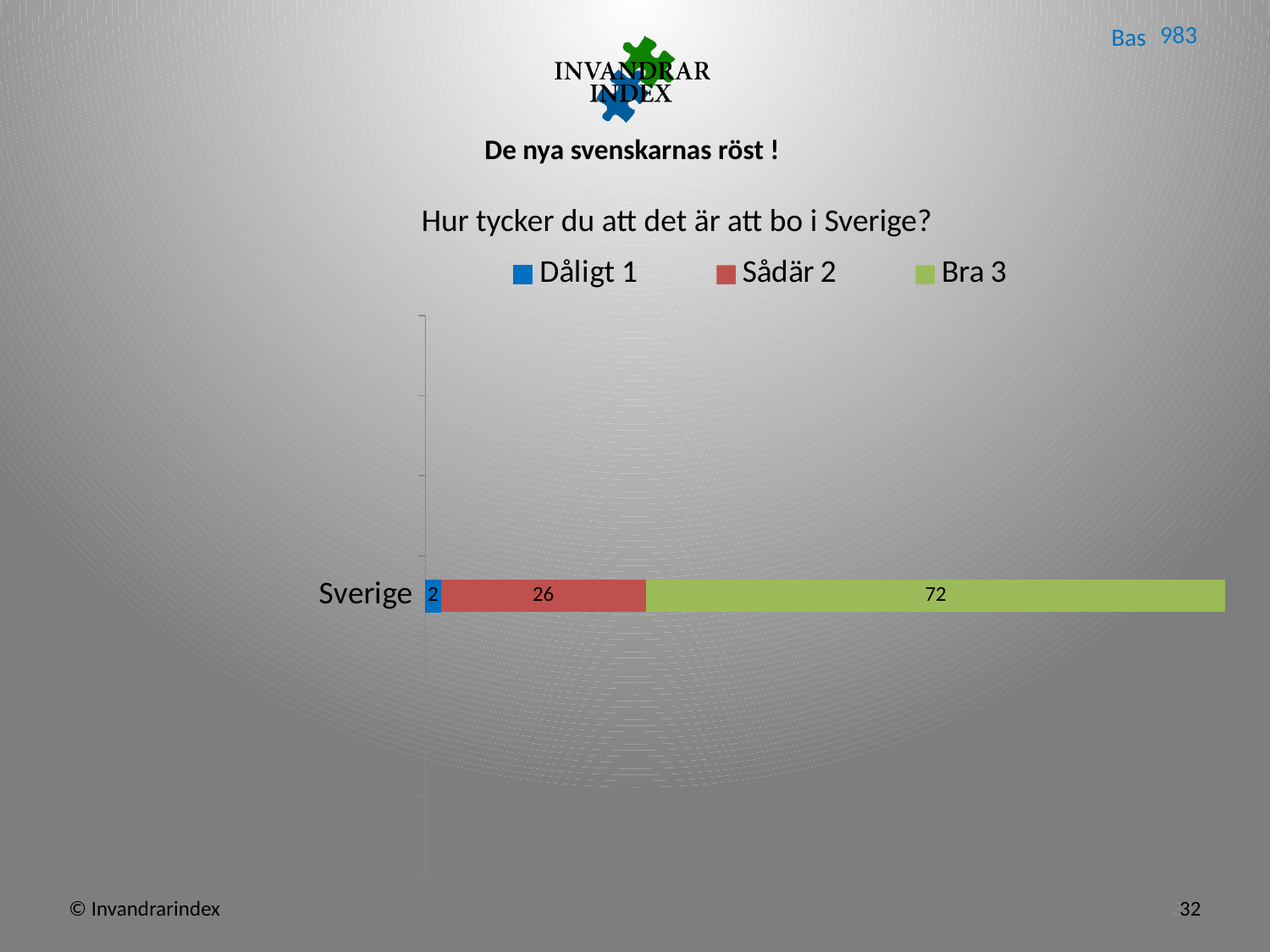
What is the value for Dåligt 1 for Sverige? 2 What is the difference between the Bra 3 and Sådär 2 values for Sverige? 46 How many categories are shown on the chart? 1 Which series has the lowest value for Sverige? Dåligt 1 Which is larger for Sverige, Sådär 2 or Dåligt 1? Sådär 2 What kind of chart is shown on the slide? Stacked bar chart What is the value for Bra 3 for Sverige? 72 What is the title of the chart? Hur tycker du att det är att bo i Sverige? What is the total of the stacked bar for Sverige? 100 How many series does the legend list? 3 What is the value for Sådär 2 for Sverige? 26 Which series has the highest value for Sverige? Bra 3